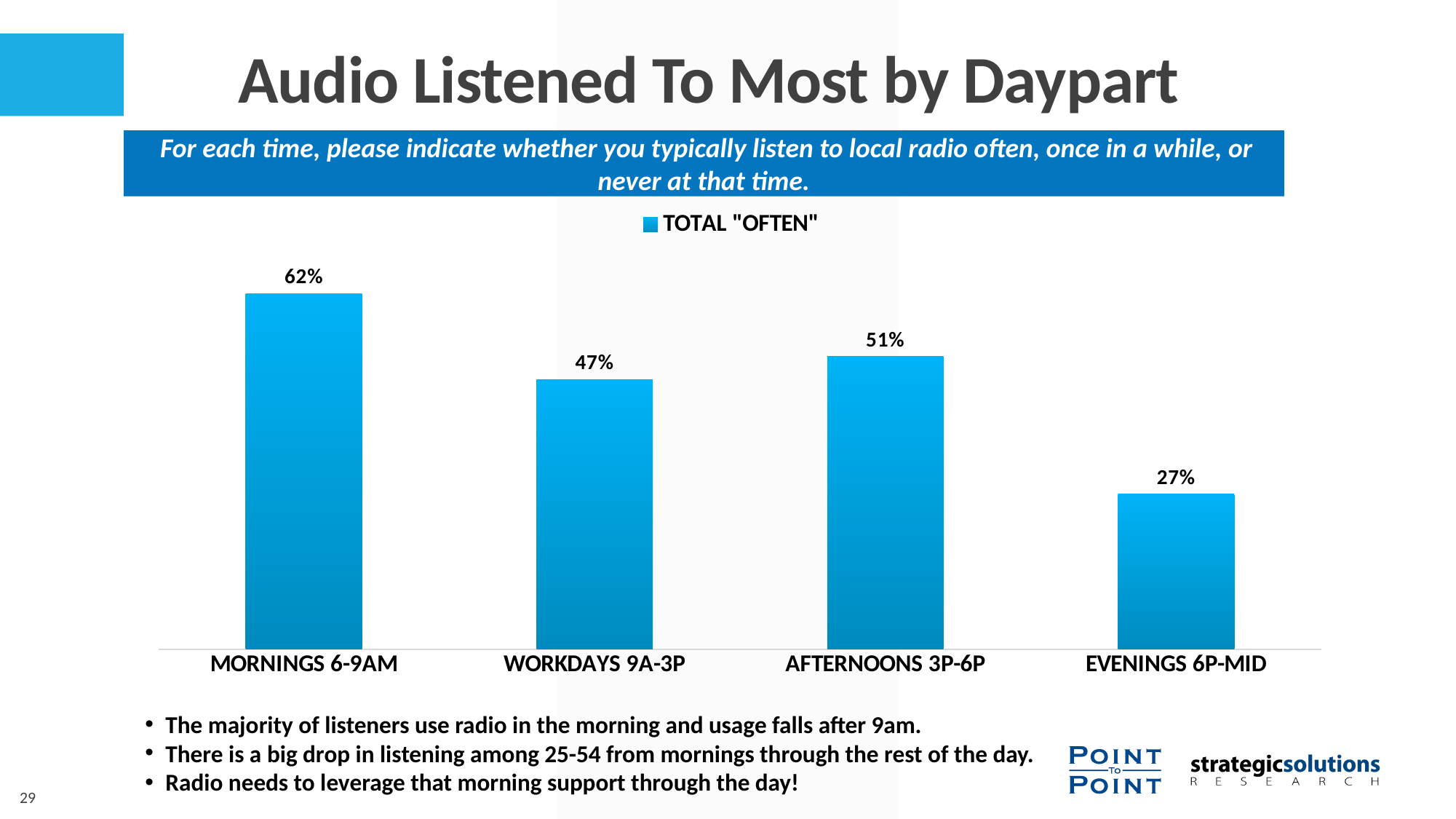
What is the value for AFTERNOONS 3P-6P? 51% Which daypart has the lowest value? EVENINGS 6P-MID What series name does the legend show? TOTAL "OFTEN" What is the value for MORNINGS 6-9AM? 62% What is the difference between the values for MORNINGS 6-9AM and EVENINGS 6P-MID? 35% How many dayparts are shown on the chart? 4 What is the difference between the values for AFTERNOONS 3P-6P and WORKDAYS 9A-3P? 4% What is the value for WORKDAYS 9A-3P? 47% What kind of chart is shown on the slide? bar chart Which is larger, the value for WORKDAYS 9A-3P or AFTERNOONS 3P-6P? AFTERNOONS 3P-6P Which daypart has the highest value? MORNINGS 6-9AM What is the value for EVENINGS 6P-MID? 27%